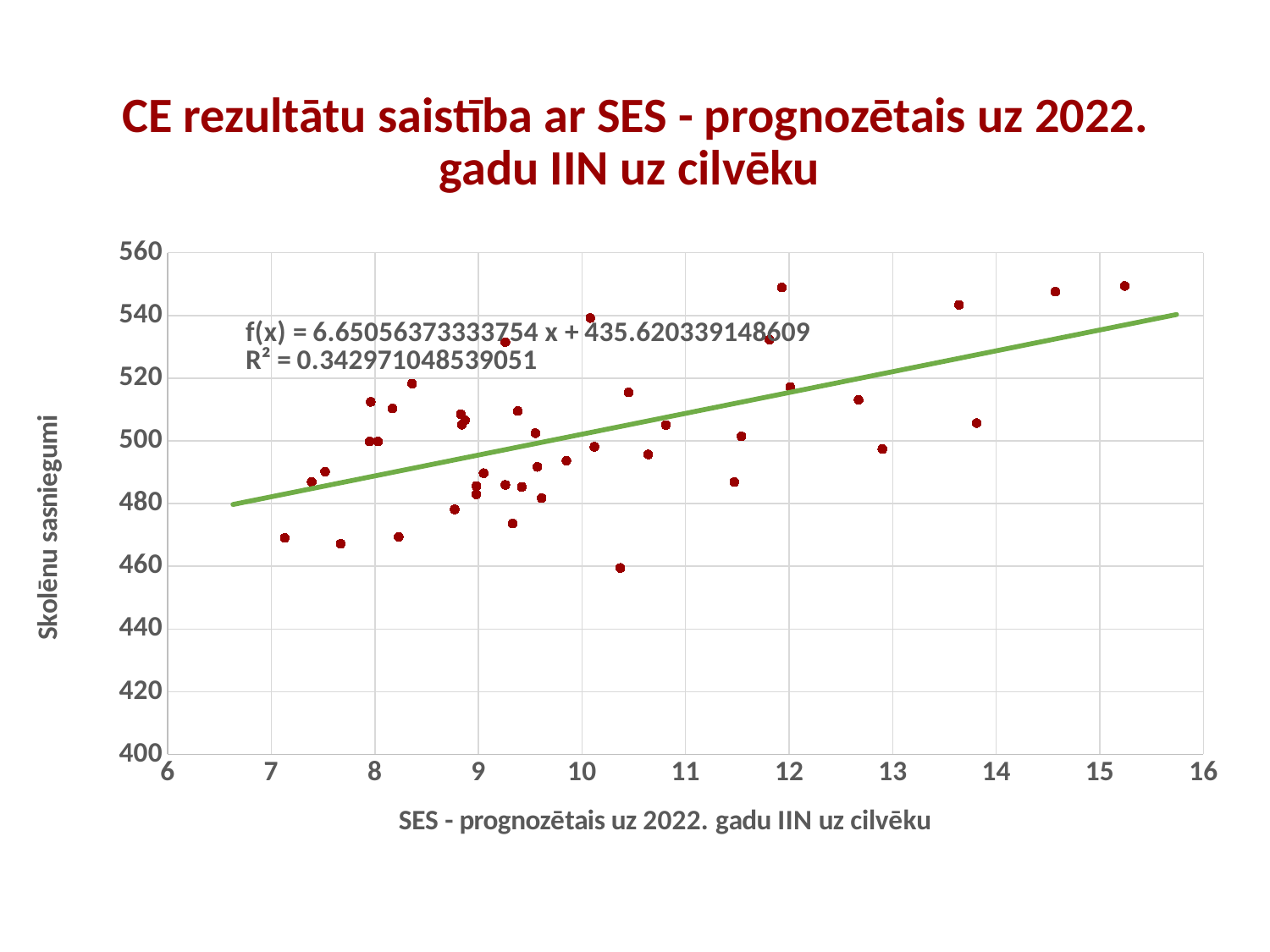
Is the value of the lowest plotted point greater or less than 480? less What is the R² value shown on the chart? 0.342971048539051 What is the intercept of the trendline equation shown on the chart? 435.620339148609 What is the minimum value shown on the horizontal axis? 6 Is the value of the highest plotted point greater or less than 540? greater What kind of chart is shown on the slide? Scatter chart What is the slope of the trendline equation shown on the chart? 6.65056373333754 Does the trendline rise or fall as the x-axis value increases? Rises What is the label of the horizontal axis? SES - prognozētais uz 2022. gadu IIN uz cilvēku What is the maximum value shown on the vertical axis? 560 What is the title of the chart? CE rezultātu saistība ar SES - prognozētais uz 2022. gadu IIN uz cilvēku